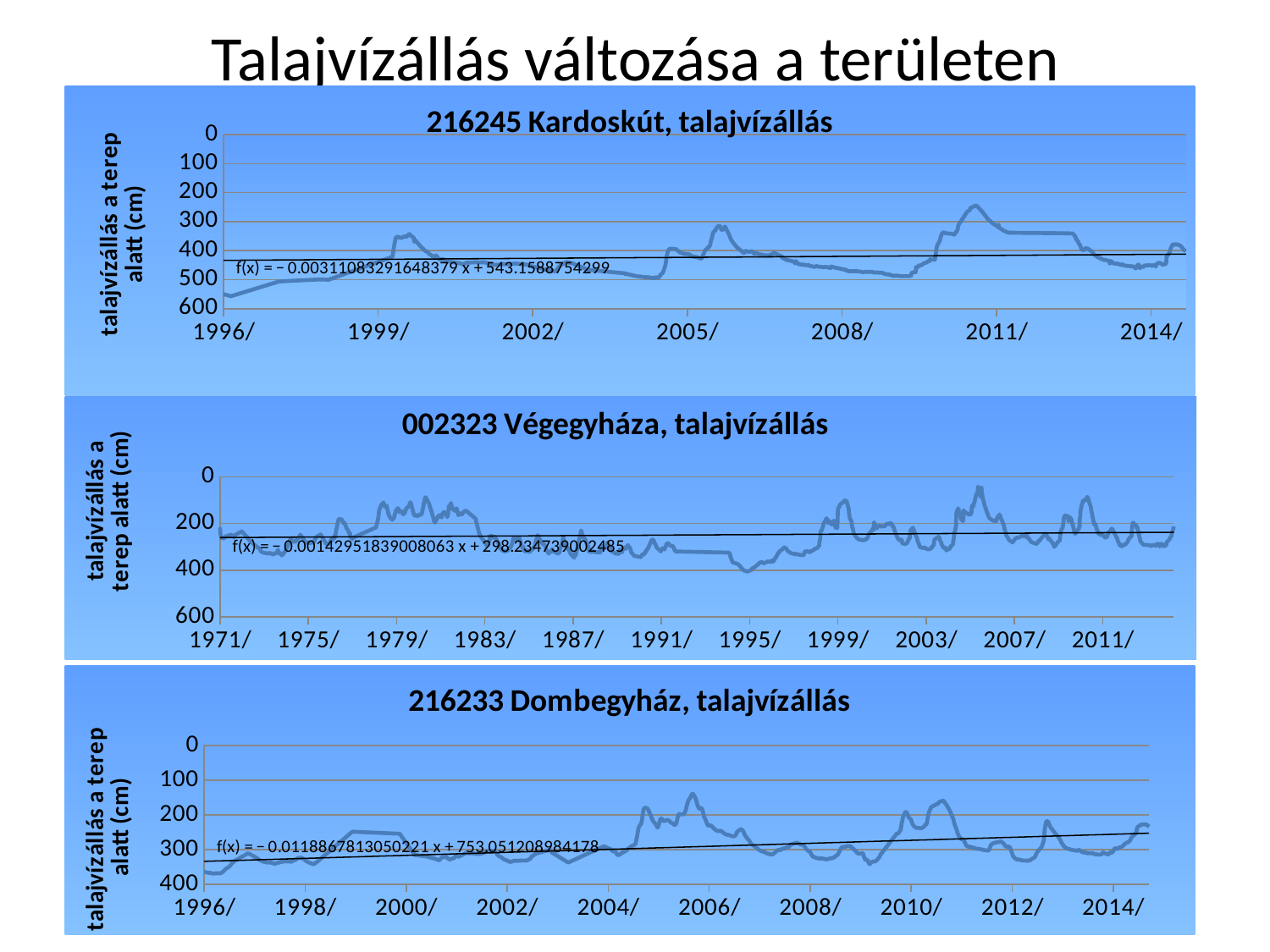
In the "216245 Kardoskút, talajvízállás" chart, is the value at the start of 1996 greater or less than 500? greater In the "002323 Végegyháza, talajvízállás" chart, what is the first year label on the x-axis? 1971/ What kind of chart is the "216245 Kardoskút, talajvízállás" chart? line chart In the "216233 Dombegyház, talajvízállás" chart, is the slope of the fitted trend line positive or negative? negative In the "216245 Kardoskút, talajvízállás" chart, what is the trend line equation printed on the chart? f(x) = − 0.00311083291648379 x + 543.1588754299 How many charts are shown on the slide? 3 What is the title of the middle chart on the slide? 002323 Végegyháza, talajvízállás In the "216233 Dombegyház, talajvízállás" chart, is the peak value around 2006 greater or less than 200? less What is the y-axis label of the "216233 Dombegyház, talajvízállás" chart? talajvízállás a terep alatt (cm) What is the highest value shown on the y-axis of the "216233 Dombegyház, talajvízállás" chart? 400 In the "002323 Végegyháza, talajvízállás" chart, what is the trend line equation printed on the chart? f(x) = − 0.00142951839008063 x + 298.234739002485 In the "216233 Dombegyház, talajvízállás" chart, what is the trend line equation printed on the chart? f(x) = − 0.0118867813050221 x + 753.051208984178